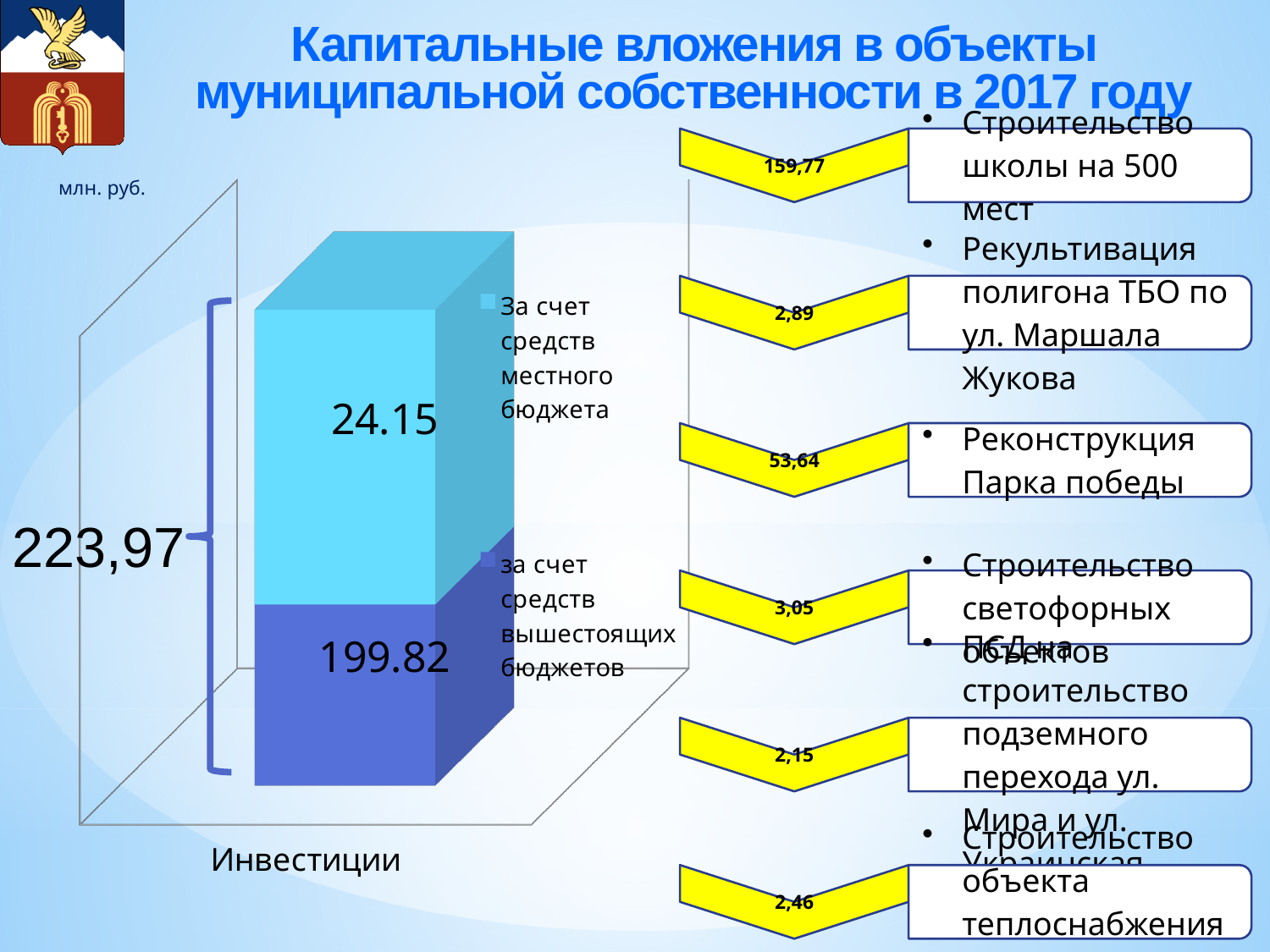
What is the value for the series "за счет средств вышестоящих бюджетов" in the chart? 199.82 What is the total of the stacked bar "Инвестиции" as shown on the slide? 223,97 What unit is indicated for the chart values? млн. руб. What is the difference between the values 199.82 and 24.15 in the chart? 175.67 Which series has the smallest value in the chart? За счет средств местного бюджета What type of chart is shown on the slide? bar chart How many categories are plotted on the x axis of the chart? 1 How many series does the chart legend list? 2 Which series has the largest value in the chart? за счет средств вышестоящих бюджетов What is the category label on the x axis of the chart? Инвестиции What is the value for the series "За счет средств местного бюджета" in the chart? 24.15 Which series has the larger value in the stacked bar: "За счет средств местного бюджета" or "за счет средств вышестоящих бюджетов"? за счет средств вышестоящих бюджетов